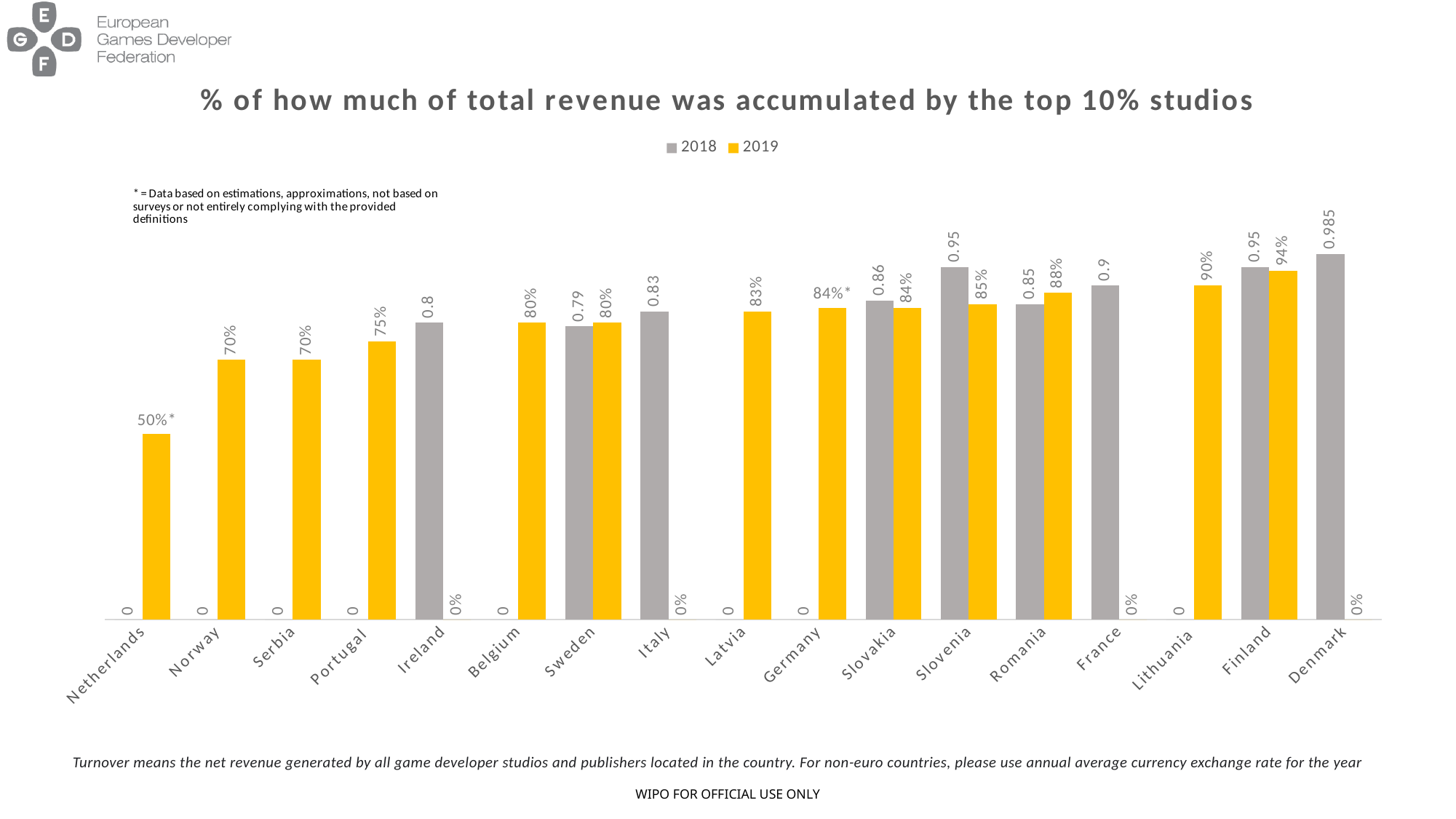
Among countries with a non-zero 2019 bar, which has the lowest 2019 value? Netherlands What is the 2018 value for Denmark? 0.985 What is the 2019 value for Netherlands? 50% What is the 2019 value for Romania? 88% How many countries are shown on the x axis? 17 Which country has the highest 2019 value? Finland What is the difference between the 2019 values for Portugal and Norway? 5% How many series does the legend list? 2 What kind of chart is shown on the slide? Bar chart What is the 2018 value for Sweden? 0.79 Which country has the highest 2018 value? Denmark For Slovenia, is the 2018 value or the 2019 value larger? 2018